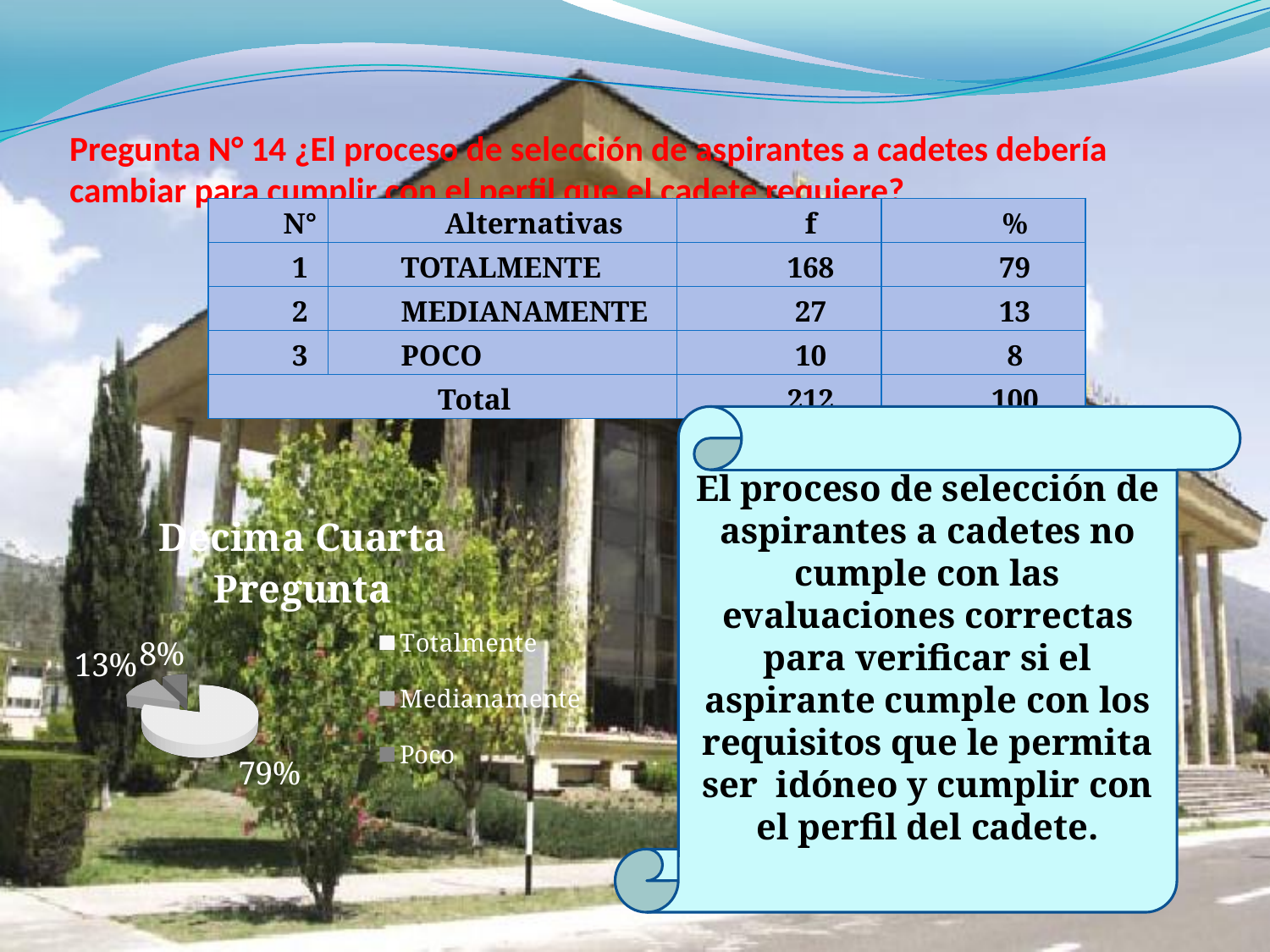
What share of the pie does Poco represent? 8% How many slices does the pie chart have? 3 What is the difference in percentage points between the Medianamente and Poco slices? 5 What share of the pie does Totalmente represent? 79% Which slice of the pie chart is the smallest? Poco What is the title of the pie chart? Décima Cuarta Pregunta What is the difference in percentage points between the Totalmente and Medianamente slices? 66 Which is larger in the pie chart, Medianamente or Poco? Medianamente Which slice of the pie chart is the largest? Totalmente What kind of chart is shown on the slide? pie chart What share of the pie does Medianamente represent? 13% How many entries does the pie chart's legend list? 3